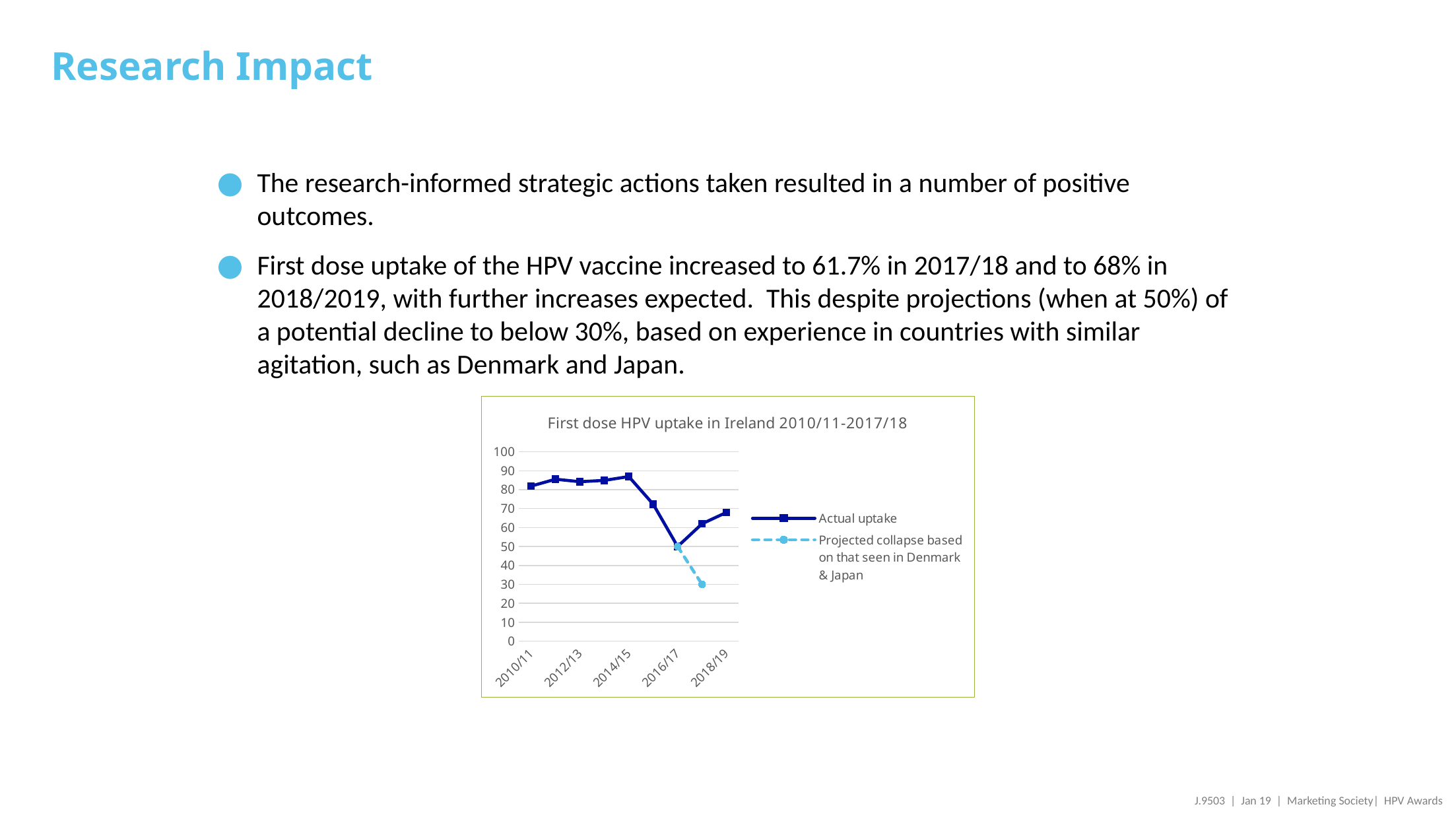
Does the Actual uptake line rise or fall between 2016/17 and 2018/19? rise Which is larger, the Actual uptake for 2010/11 or for 2016/17? 2010/11 Does the Actual uptake line rise or fall between 2014/15 and 2016/17? fall Is the Actual uptake value for 2018/19 greater or less than 60? greater Is the Actual uptake value for 2010/11 greater or less than 70? greater Is the Actual uptake value for 2014/15 greater or less than 80? greater What is the title of the chart? First dose HPV uptake in Ireland 2010/11-2017/18 How many series does the chart legend list? 2 Which year has the lowest value on the Actual uptake line? 2016/17 Which series is drawn with a dashed line? Projected collapse based on that seen in Denmark & Japan What kind of chart is shown on the slide? line chart